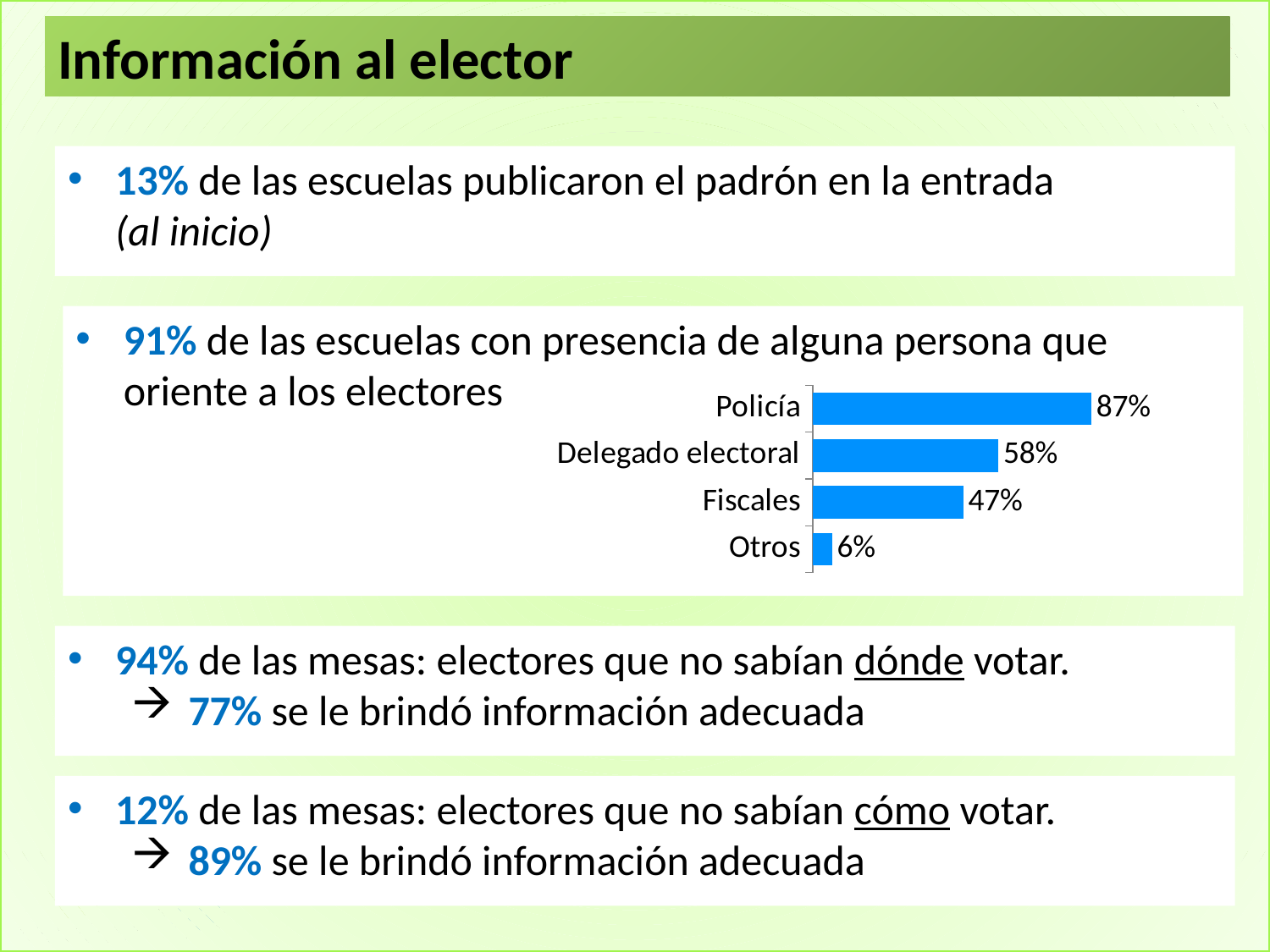
What kind of chart is shown on the slide? Bar chart Which category has the lowest value in the bar chart? Otros What is the difference between the values for Policía and Delegado electoral? 29% How many categories are shown in the bar chart? 4 What is the value for Policía in the bar chart? 87% What is the value for Fiscales in the bar chart? 47% What is the value for Otros in the bar chart? 6% What colour are the bars in the chart? Blue What is the value for Delegado electoral in the bar chart? 58% Which is larger, the value for Delegado electoral or the value for Fiscales? Delegado electoral Which category has the highest value in the bar chart? Policía What is the difference between the values for Fiscales and Otros? 41%